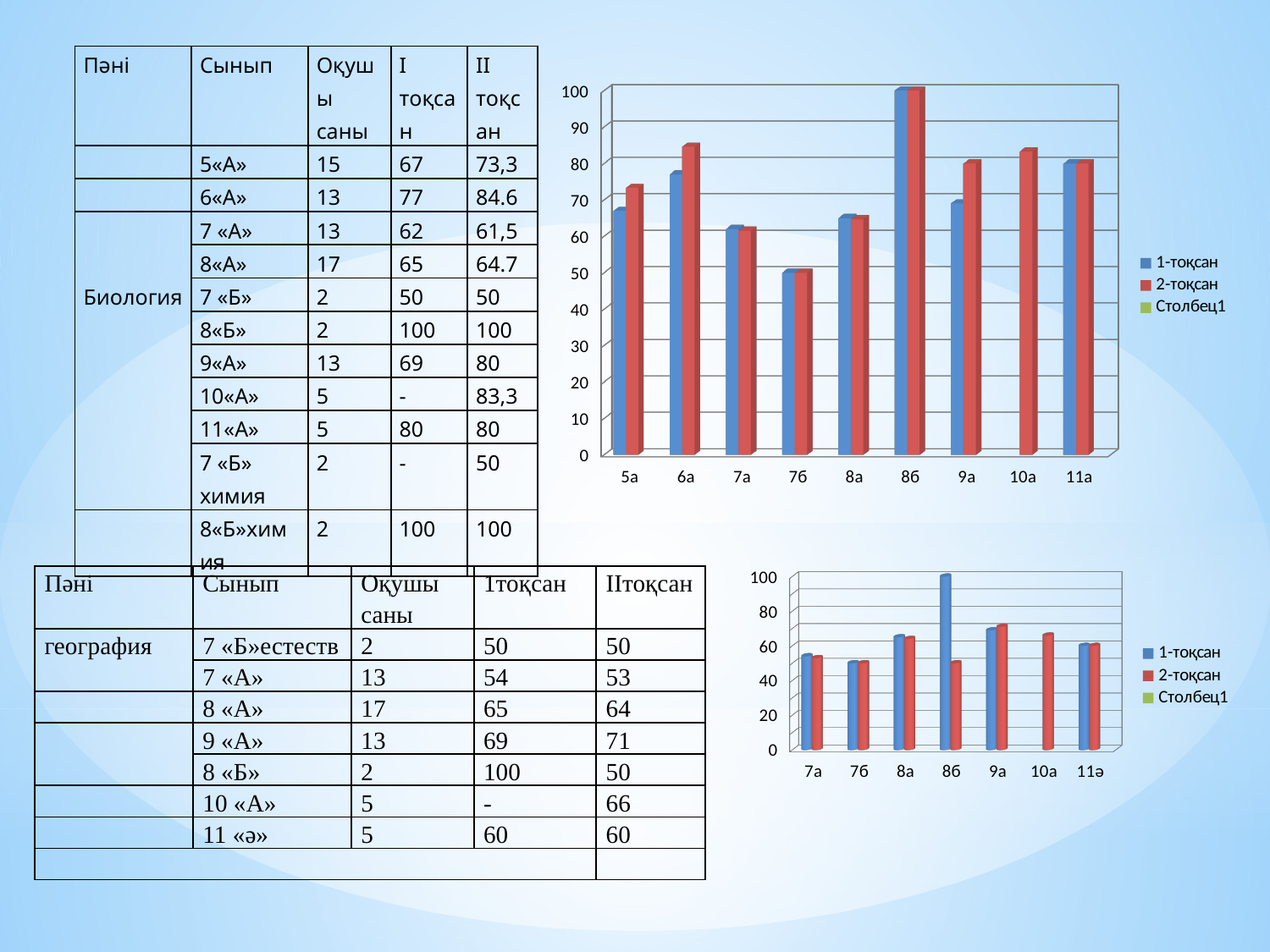
How many categories are shown on the x axis of the bottom chart? 7 In the top chart, what is the value of the 1-тоқсан bar for 8б? 100 In the bottom chart, which is larger for 8б: the 1-тоқсан bar or the 2-тоқсан bar? 1-тоқсан What kind of chart is the top chart on the slide? bar chart In the bottom chart, which category has the highest bar? 8б In the top chart, which category has the highest bars? 8б In the top chart, is the 2-тоқсан value for 6а greater or less than 80? greater In the top chart, which is larger for 9а: the 1-тоқсан bar or the 2-тоқсан bar? 2-тоқсан How many series does the legend of the top chart list? 3 In the top chart, which category has the lowest bars? 7б In the bottom chart, is the 1-тоқсан value for 7б greater or less than 60? less How many categories are shown on the x axis of the top chart? 9